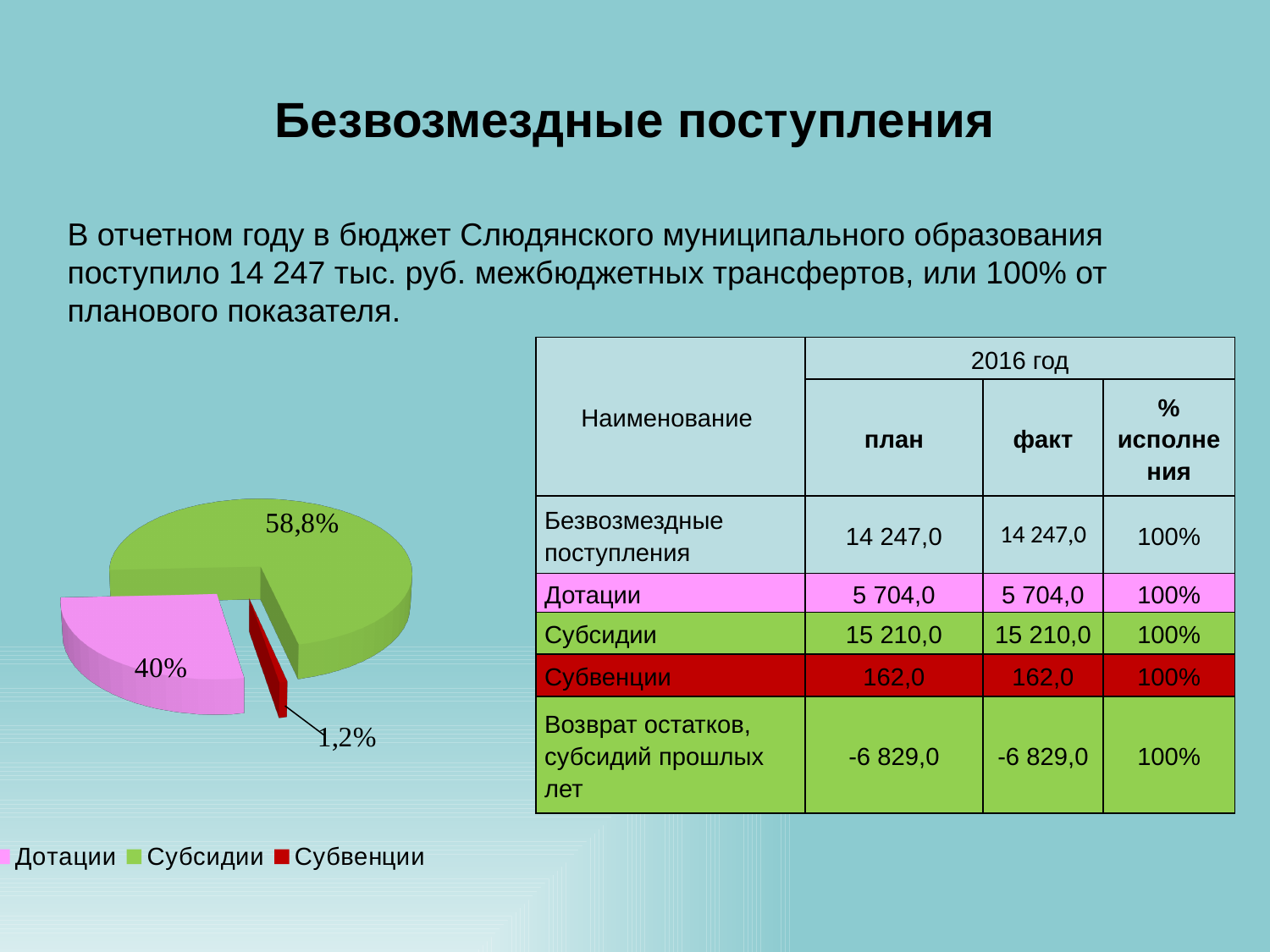
Which slice of the pie chart is the largest? Субсидии How many entries does the legend of the pie chart list? 3 What is the difference in percentage points between the Субсидии and Дотации slices? 18,8 What share of the pie does Субвенции have? 1,2% Which slice of the pie chart is the smallest? Субвенции How many slices does the pie chart have? 3 What share of the pie does Дотации have? 40% What kind of chart is shown on the slide? pie chart What colour is the Дотации slice in the pie chart? pink Which is larger in the pie chart, Дотации or Субвенции? Дотации What share of the pie does Субсидии have? 58,8% What colour is the Субвенции slice in the pie chart? red